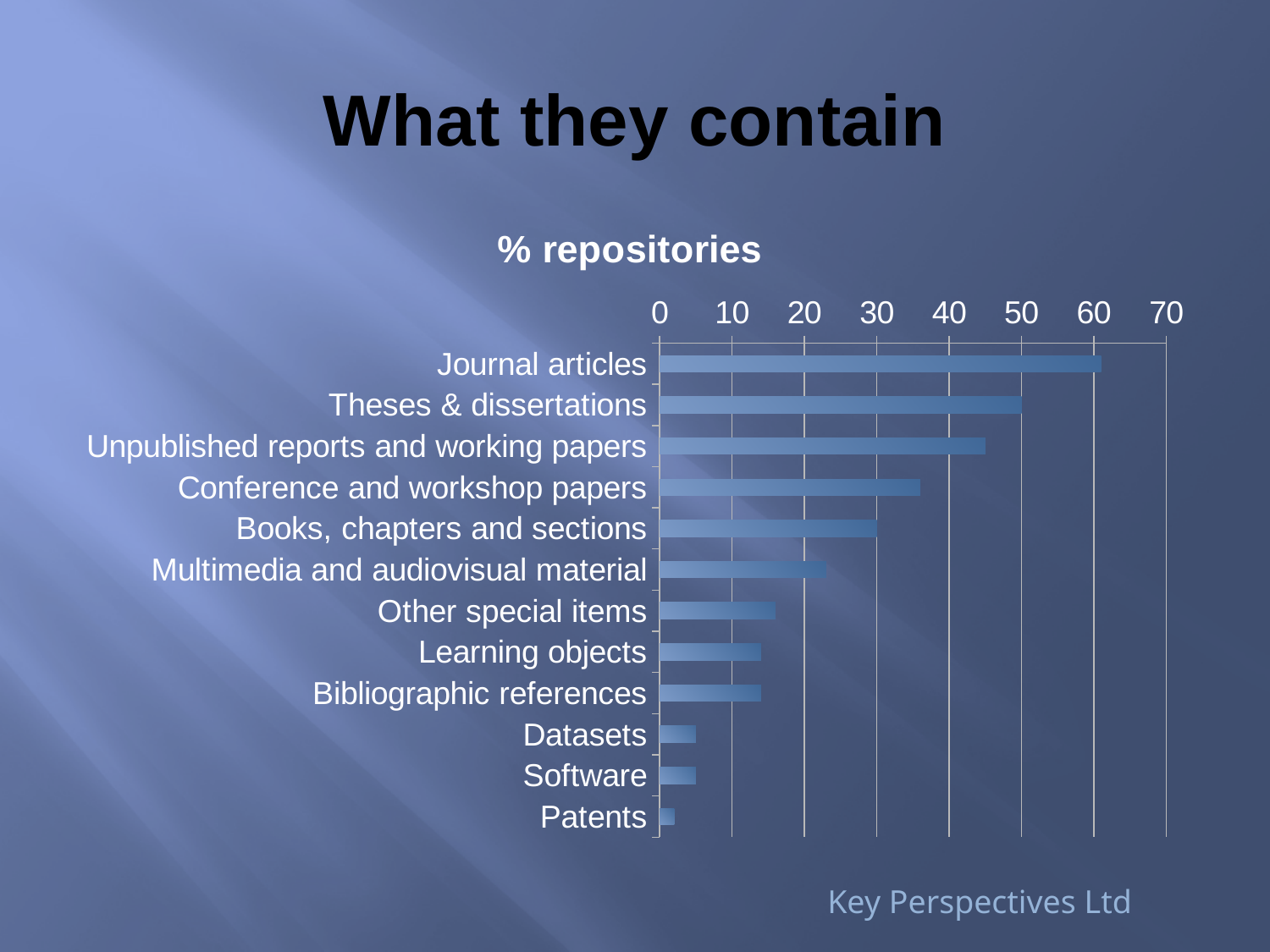
Which is larger, the value for Other special items or the value for Patents? Other special items Which category has the lowest value? Patents Is the value for Conference and workshop papers greater or less than 40? less What kind of chart is shown on the slide? bar chart Is the value for Multimedia and audiovisual material greater or less than 20? greater Which is larger, the value for Theses & dissertations or the value for Conference and workshop papers? Theses & dissertations What is the title of the chart? % repositories Is the value for Datasets greater or less than 10? less Which category has the highest value? Journal articles How many categories are plotted in the chart? 12